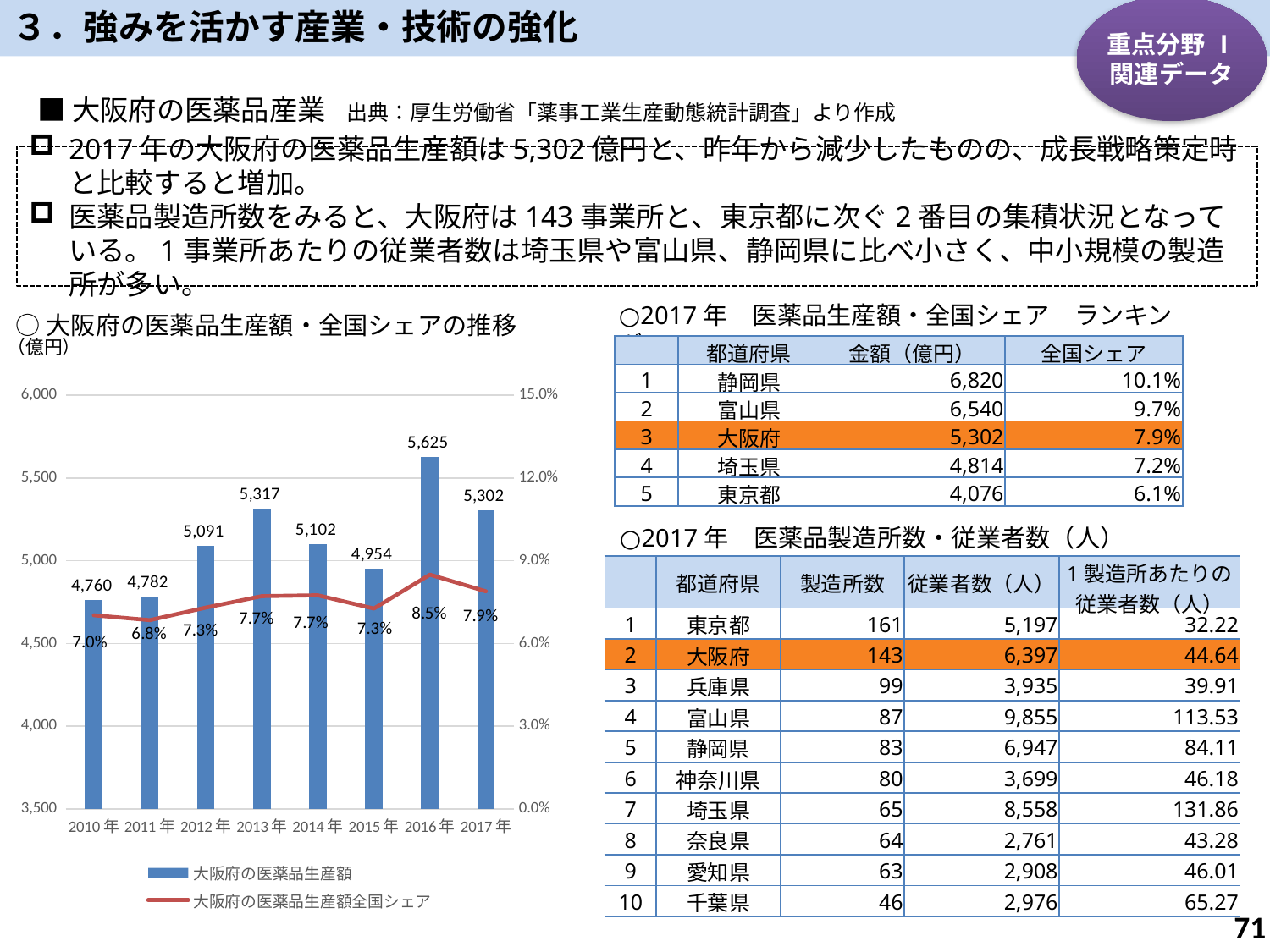
In the chart of Osaka's pharmaceutical production value and national share, what is the national share for 2016年? 8.5% In the chart of Osaka's pharmaceutical production value and national share, how many years are plotted on the x axis? 8 In the chart of Osaka's pharmaceutical production value and national share, which year has the larger production value, 2013年 or 2014年? 2013年 In the chart of Osaka's pharmaceutical production value and national share, how many series does the legend list? 2 In the chart of Osaka's pharmaceutical production value and national share, what is the production value (億円) for 2016年? 5,625 In the chart of Osaka's pharmaceutical production value and national share, which year has the lowest production value? 2010年 In the chart of Osaka's pharmaceutical production value and national share, what is the difference in production value between 2016年 and 2017年? 323 In the chart of Osaka's pharmaceutical production value and national share, what is the production value (億円) for 2010年? 4,760 In the chart of Osaka's pharmaceutical production value and national share, did the production value rise or fall from 2016年 to 2017年? Fall In the chart of Osaka's pharmaceutical production value and national share, what is the national share for 2011年? 6.8% In the chart of Osaka's pharmaceutical production value and national share, what kind of chart is used for 大阪府の医薬品生産額? Bar chart In the chart of Osaka's pharmaceutical production value and national share, which year has the highest production value? 2016年